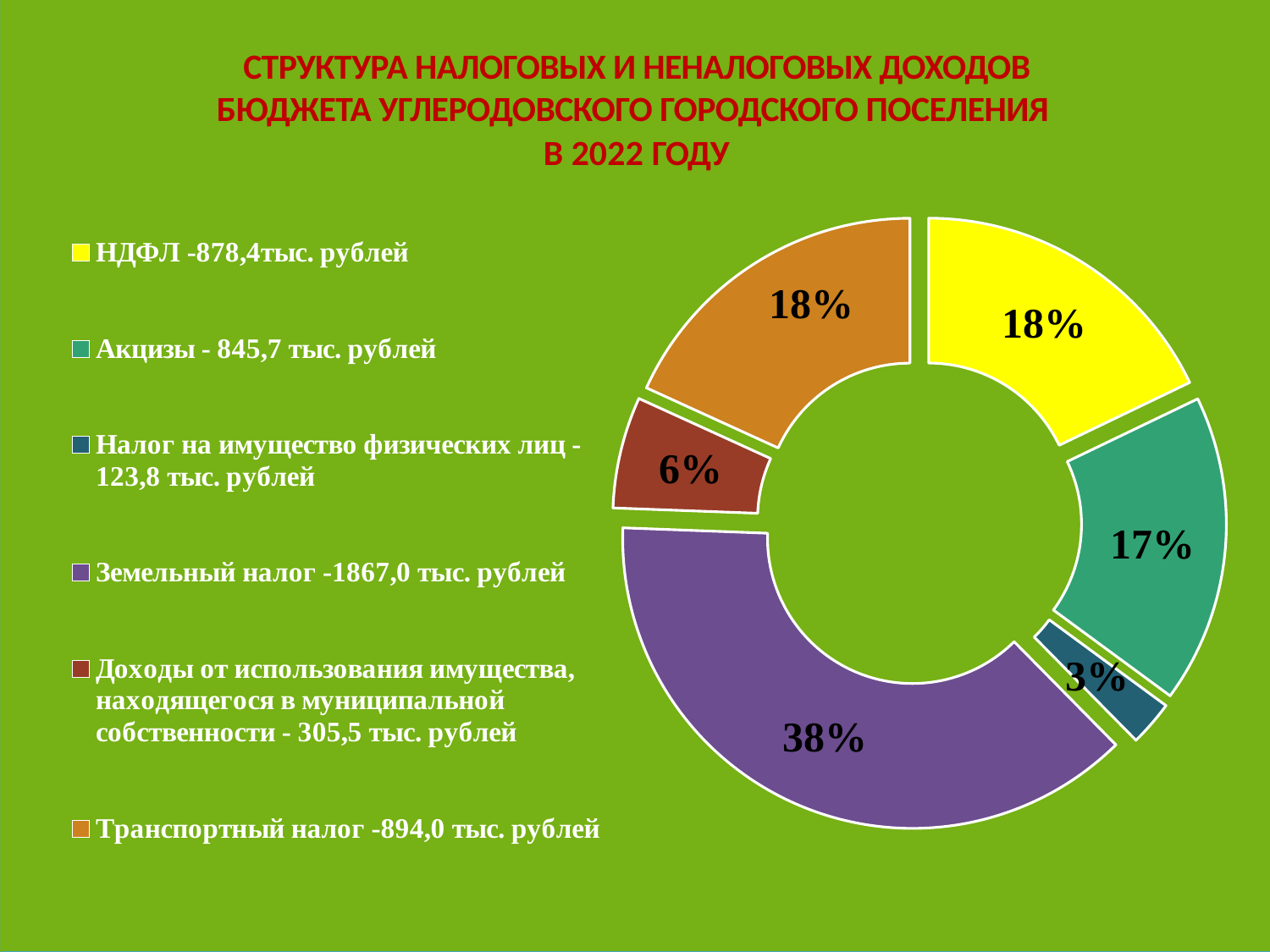
What share of the chart does Земельный налог account for? 38% Which has a larger share: Транспортный налог or Доходы от использования имущества, находящегося в муниципальной собственности? Транспортный налог What share of the chart does Доходы от использования имущества, находящегося в муниципальной собственности account for? 6% What share of the chart does Налог на имущество физических лиц account for? 3% What is the difference in percentage points between the share of Земельный налог and the share of Акцизы? 21 Which year does the chart title refer to? 2022 According to the legend, what is the amount for Транспортный налог? 894,0 тыс. рублей Which category has the smallest share of the chart? Налог на имущество физических лиц Which category has the largest share of the chart? Земельный налог How many categories does the chart show? 6 What kind of chart is shown on the slide? Doughnut chart